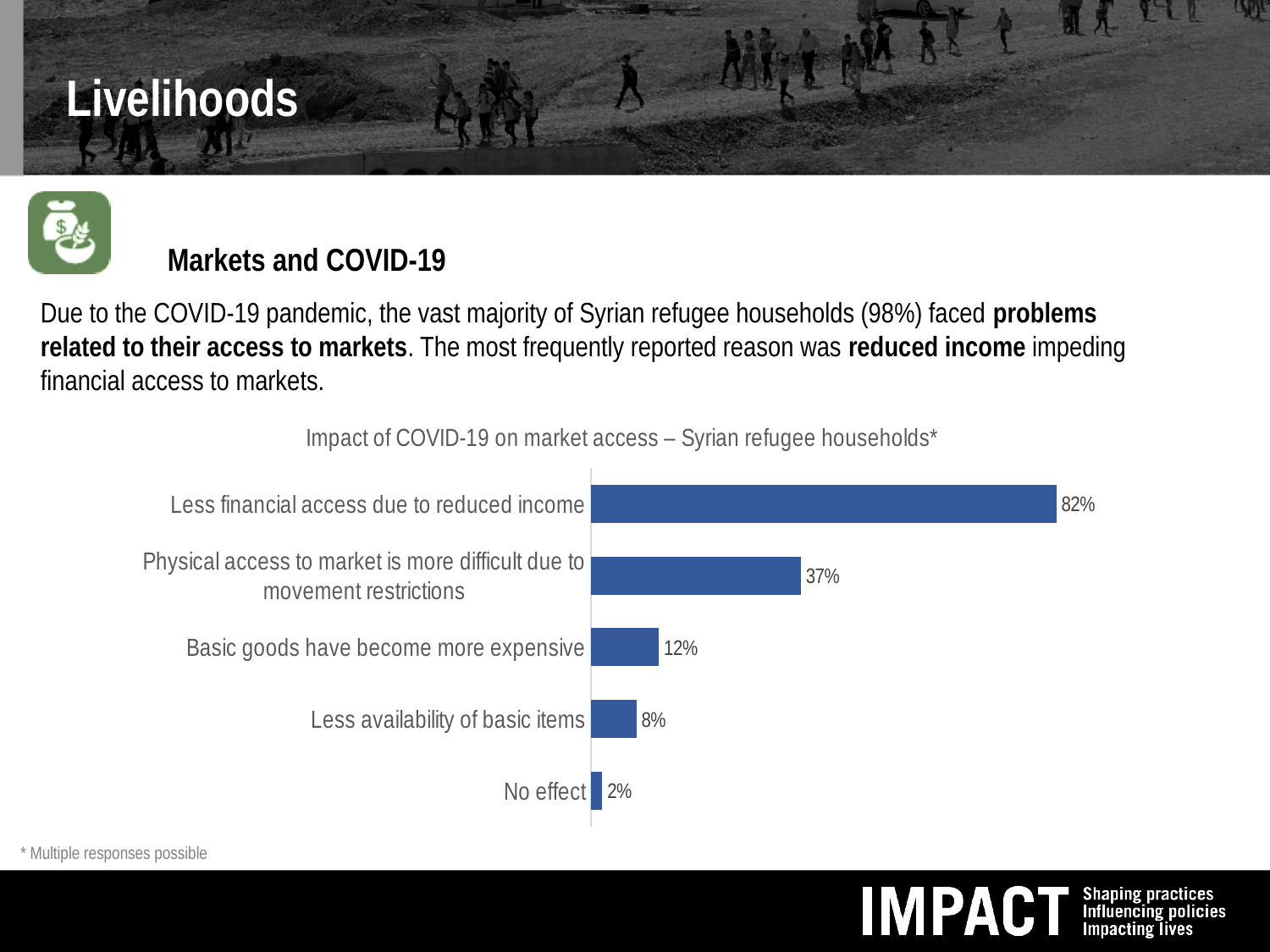
How many categories are shown in the chart? 5 Which category has the lowest value in the chart? No effect What is the value for 'Less availability of basic items'? 8% What is the difference between the values for 'Less financial access due to reduced income' and 'Physical access to market is more difficult due to movement restrictions'? 45% Which category has the highest value in the chart? Less financial access due to reduced income Which is larger: the value for 'Basic goods have become more expensive' or 'Less availability of basic items'? Basic goods have become more expensive What type of chart is shown on the slide? Bar chart What percentage of households reported no effect? 2% What percentage of Syrian refugee households reported less financial access due to reduced income? 82% What is the title of the chart? Impact of COVID-19 on market access – Syrian refugee households* What is the value for 'Physical access to market is more difficult due to movement restrictions'? 37% What percentage reported that basic goods have become more expensive? 12%